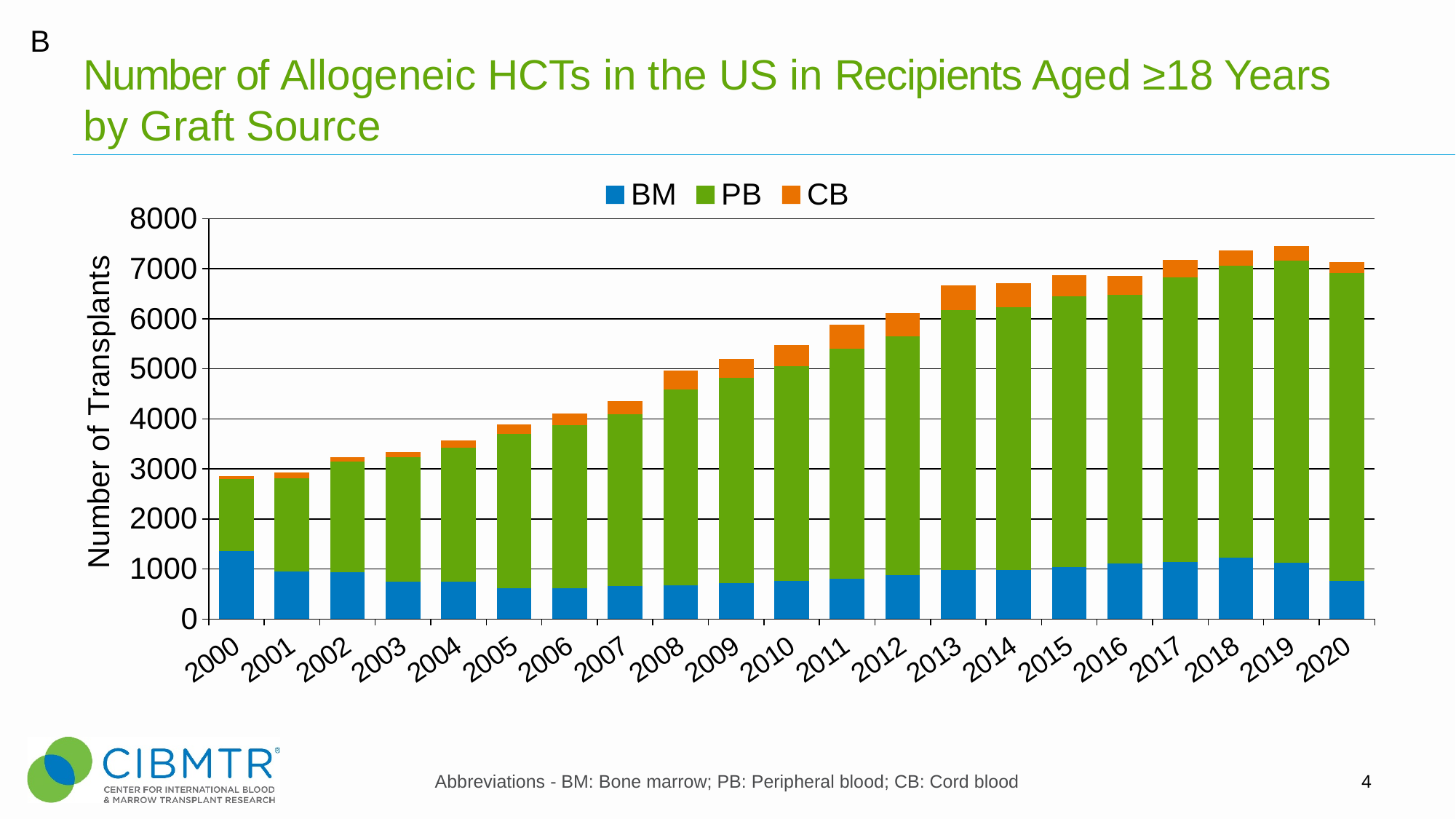
What kind of chart is shown on the slide? Stacked bar chart Is the total number of transplants for 2000 greater or less than 3000? less Is the BM value for 2000 greater or less than 1000? greater Do the total bar heights generally rise or fall from 2000 to 2019? rise Is the total number of transplants for 2013 greater or less than 6000? greater Which year has the taller total bar, 2019 or 2020? 2019 Which series is shown in green in the legend? PB How many years are shown along the x axis? 21 What is the label on the y axis? Number of Transplants Which year has the largest BM segment? 2000 How many series does the legend list? 3